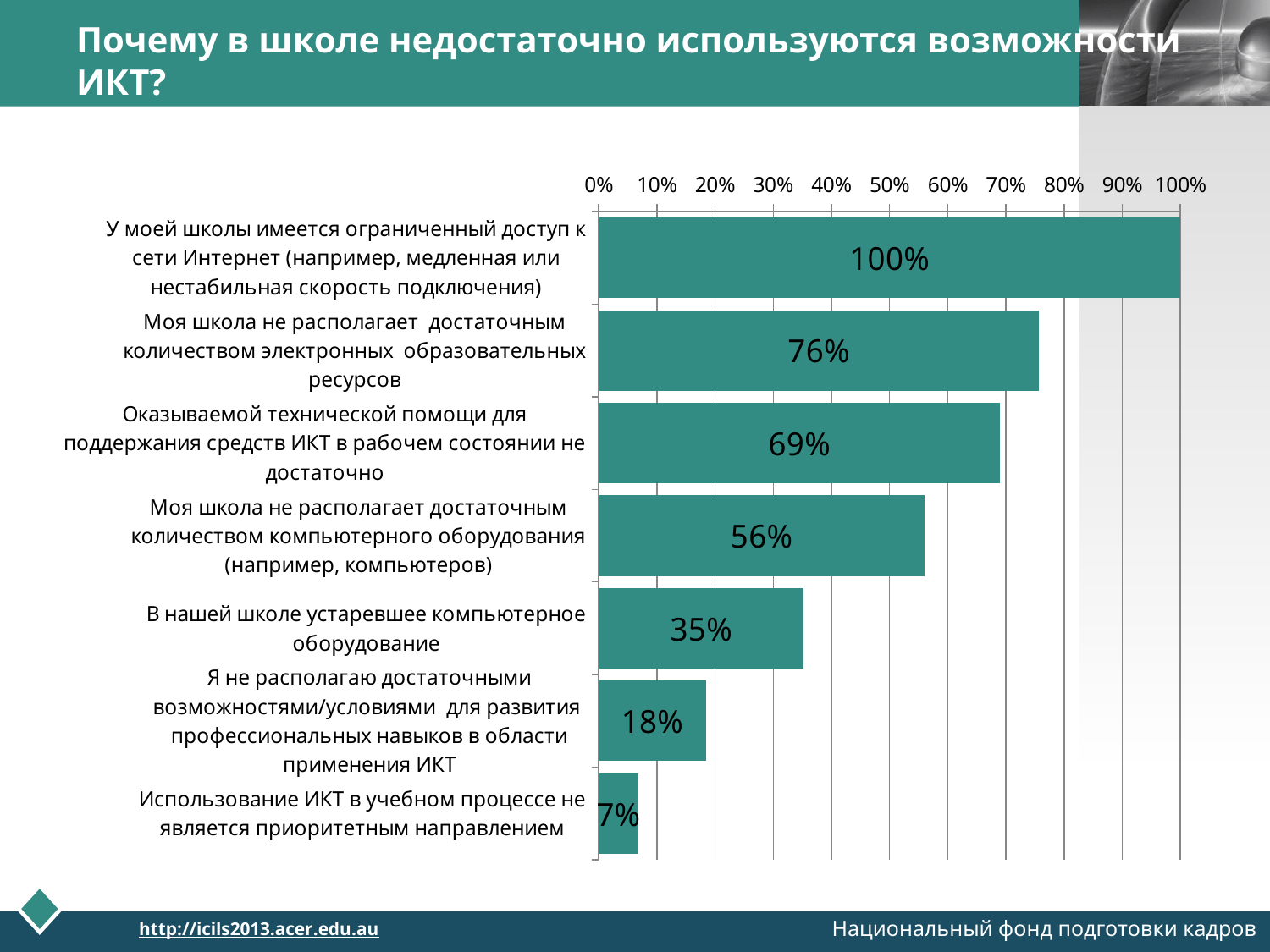
What is the title of the slide containing the chart? Почему в школе недостаточно используются возможности ИКТ? Which category has the lowest value? Использование ИКТ в учебном процессе не является приоритетным направлением What is the difference between the value for 'Оказываемой технической помощи для поддержания средств ИКТ в рабочем состоянии не достаточно' and the value for 'Моя школа не располагает достаточным количеством компьютерного оборудования (например, компьютеров)'? 13% What kind of chart is shown on the slide? bar chart How many categories are shown in the chart? 7 Which is larger: the value for 'В нашей школе устаревшее компьютерное оборудование' or the value for 'Я не располагаю достаточными возможностями/условиями для развития профессиональных навыков в области применения ИКТ'? В нашей школе устаревшее компьютерное оборудование What value is shown for 'Моя школа не располагает достаточным количеством электронных образовательных ресурсов'? 76% What is the difference between the highest and lowest values in the chart? 93% Which category has the highest value? У моей школы имеется ограниченный доступ к сети Интернет (например, медленная или нестабильная скорость подключения) What value is shown for the category 'В нашей школе устаревшее компьютерное оборудование'? 35% What value is shown for 'Использование ИКТ в учебном процессе не является приоритетным направлением'? 7% Is the value for 'Оказываемой технической помощи для поддержания средств ИКТ в рабочем состоянии не достаточно' greater or less than 60%? greater